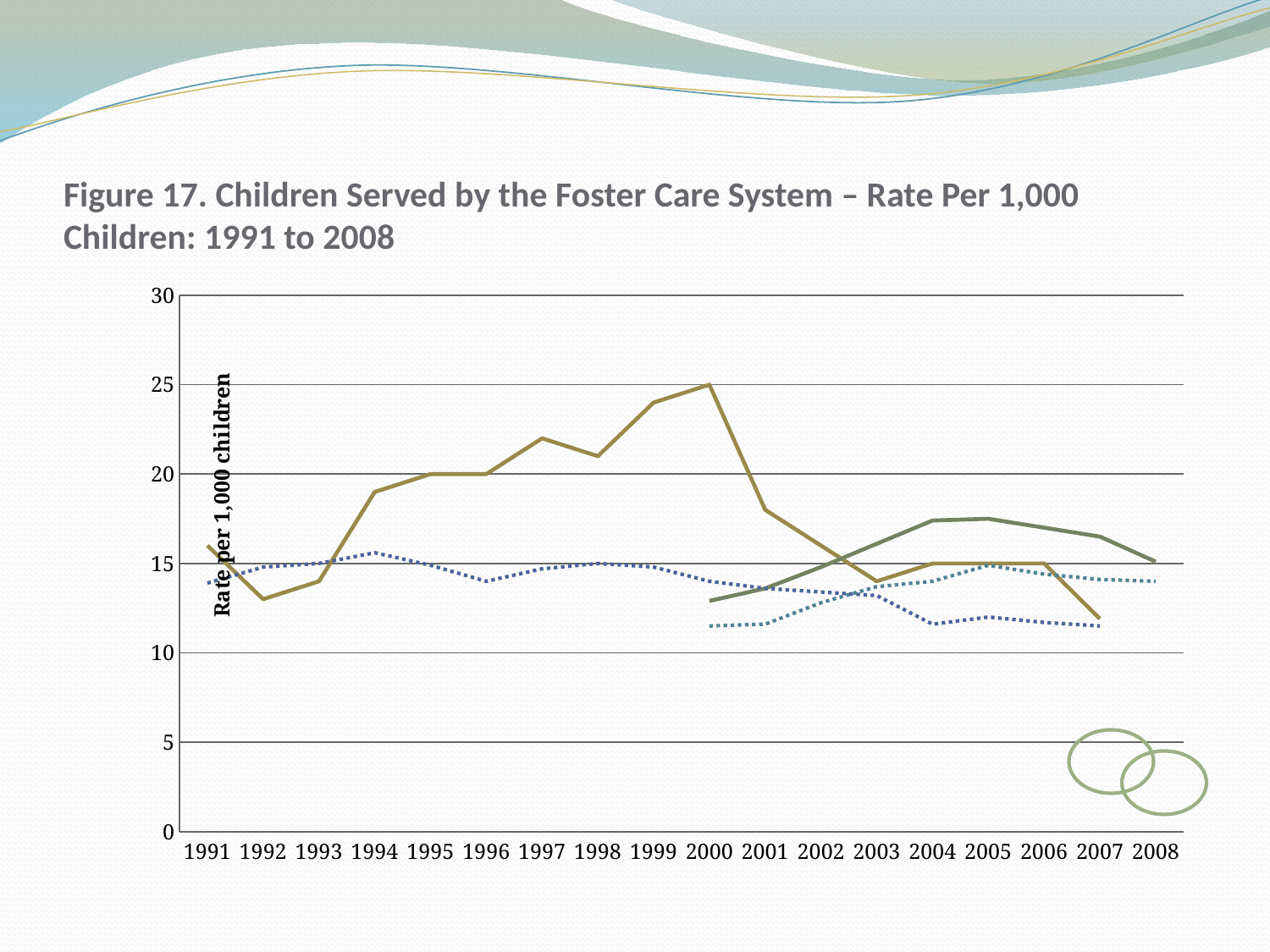
How many years are shown along the x axis of the chart? 18 Is the value of the solid gold line in 1999 greater or less than 20? greater What is the title of the chart on the slide? Figure 17. Children Served by the Foster Care System – Rate Per 1,000 Children: 1991 to 2008 What is the label on the vertical axis of the chart? Rate per 1,000 children Is the value of the solid gold line in 2007 greater or less than 15? less Is the value of the solid green line in 2005 greater or less than 15? greater Does the solid gold line rise or fall between 2000 and 2007? fall In which year does the solid gold line reach its highest value? 2000 What value does the solid gold line reach in 2000? 25 What kind of chart is shown on the slide? line chart What is the value of the solid gold line in 1995? 20